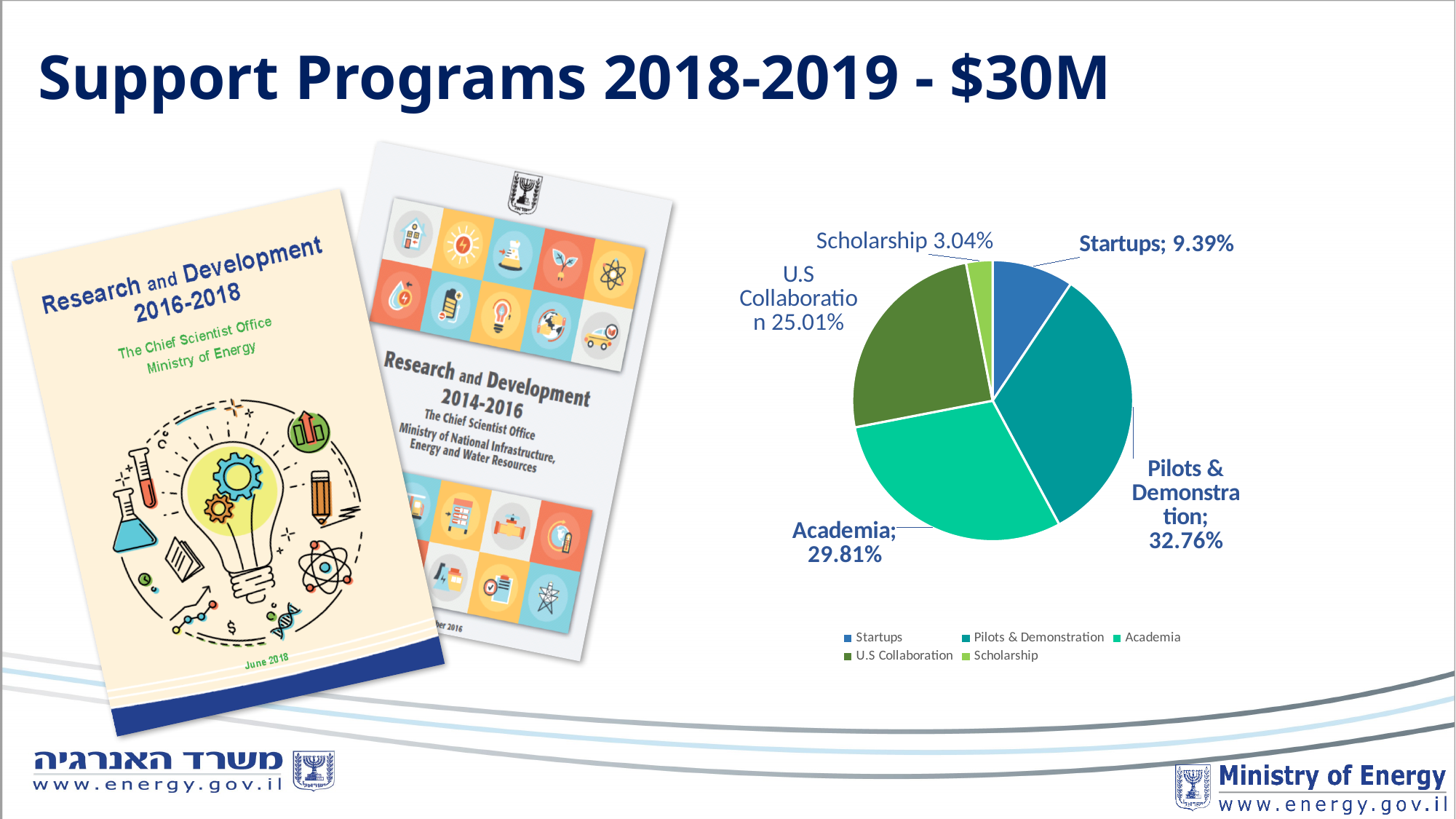
What share of the pie does Scholarship represent? 3.04% Which category has the largest slice of the pie? Pilots & Demonstration What share of the pie does Pilots & Demonstration represent? 32.76% Which category has the smallest slice of the pie? Scholarship What is the difference in percentage points between Pilots & Demonstration and Startups? 23.37 How many entries does the legend of the pie chart list? 5 What kind of chart is shown on the slide? pie chart Which is larger, the share for Academia or the share for U.S Collaboration? Academia What share of the pie does U.S Collaboration represent? 25.01% How many categories are shown in the pie chart? 5 What share of the pie does Startups represent? 9.39% What share of the pie does Academia represent? 29.81%